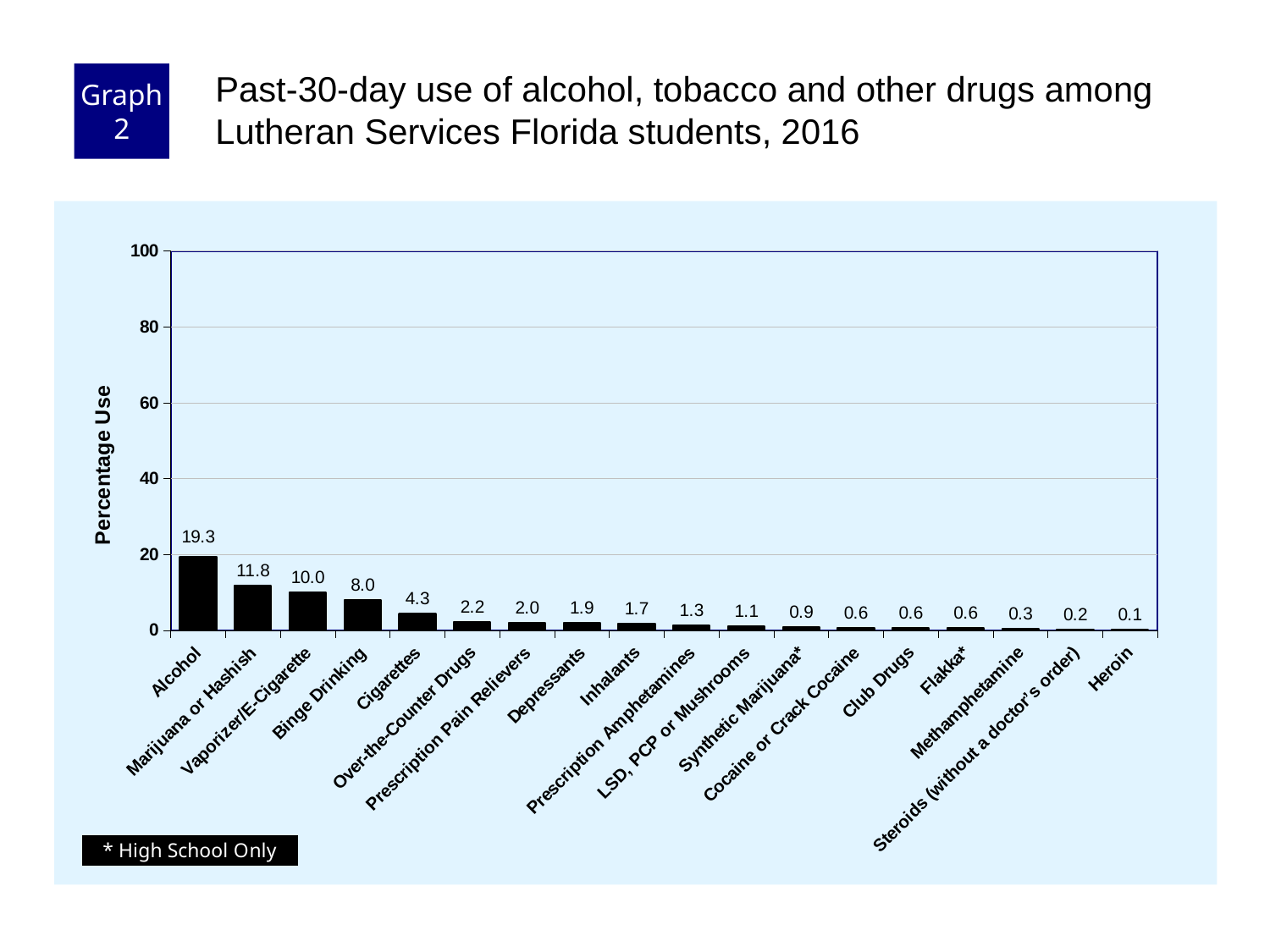
Which is larger, the value for Over-the-Counter Drugs or the value for Depressants? Over-the-Counter Drugs Is the value for Marijuana or Hashish greater or less than 20? less How many categories are shown on the x axis? 18 What kind of chart is shown on the slide? bar chart What is the value shown for Inhalants? 1.7 Which category has the highest percentage use? Alcohol What is the difference between the values for Binge Drinking and Cigarettes? 3.7 What is the past-30-day use percentage for Alcohol? 19.3 Which category has the lowest percentage use? Heroin What is the value shown for Vaporizer/E-Cigarette? 10.0 What is the difference between the values for Alcohol and Marijuana or Hashish? 7.5 What is the label of the y axis? Percentage Use